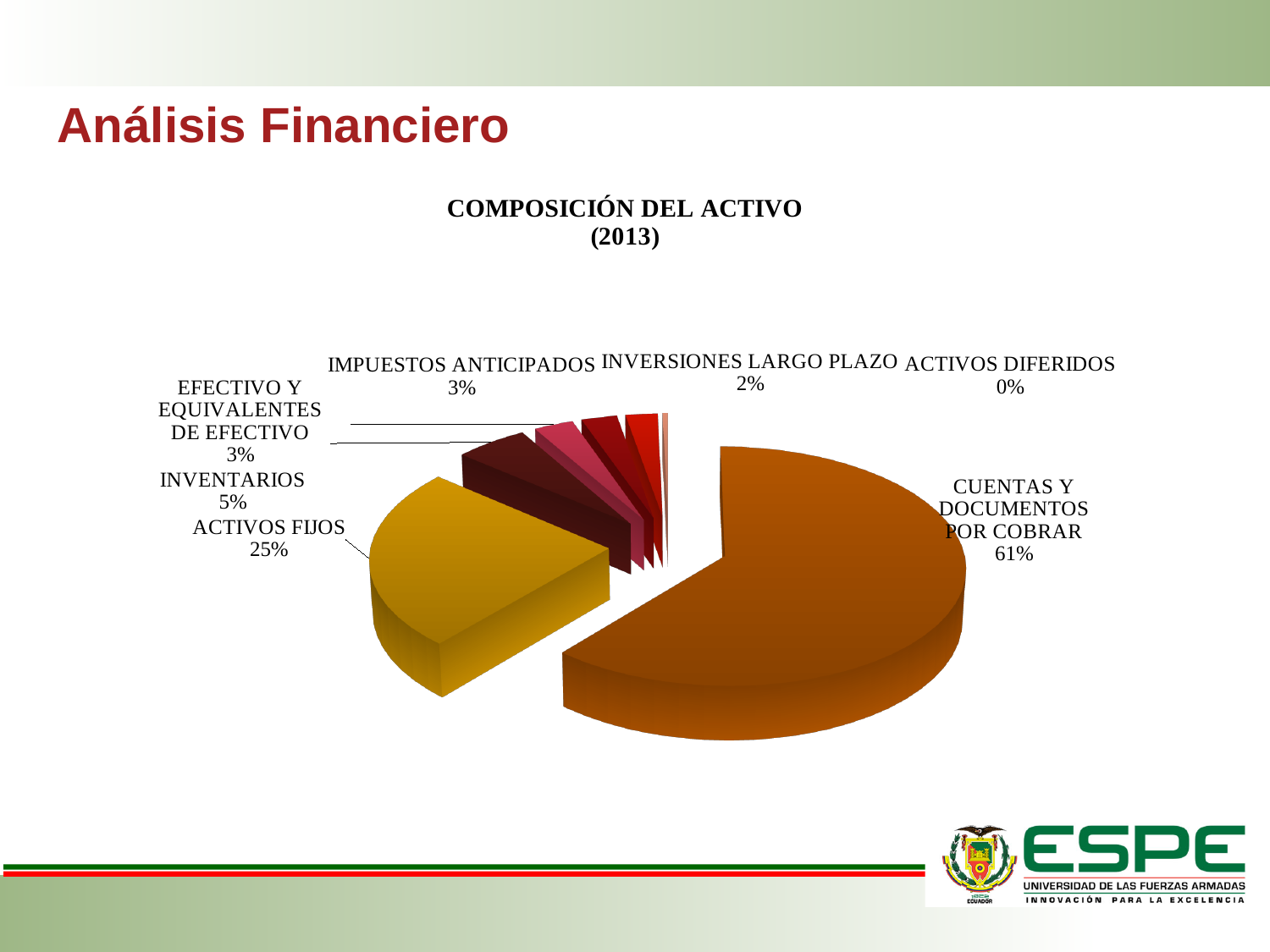
What share of the pie does CUENTAS Y DOCUMENTOS POR COBRAR represent? 61% How many categories are shown in the pie chart? 7 What is the value shown for INVERSIONES LARGO PLAZO? 2% Which category has the smallest share of the pie? ACTIVOS DIFERIDOS What is the title of the chart? COMPOSICIÓN DEL ACTIVO (2013) What share of the pie does ACTIVOS FIJOS represent? 25% What is the value shown for INVENTARIOS? 5% Which is larger, the share for INVENTARIOS or the share for IMPUESTOS ANTICIPADOS? INVENTARIOS What is the difference between the shares of CUENTAS Y DOCUMENTOS POR COBRAR and ACTIVOS FIJOS? 36% What kind of chart is shown on the slide? Pie chart What is the value shown for ACTIVOS DIFERIDOS? 0% Which category has the largest share of the pie? CUENTAS Y DOCUMENTOS POR COBRAR